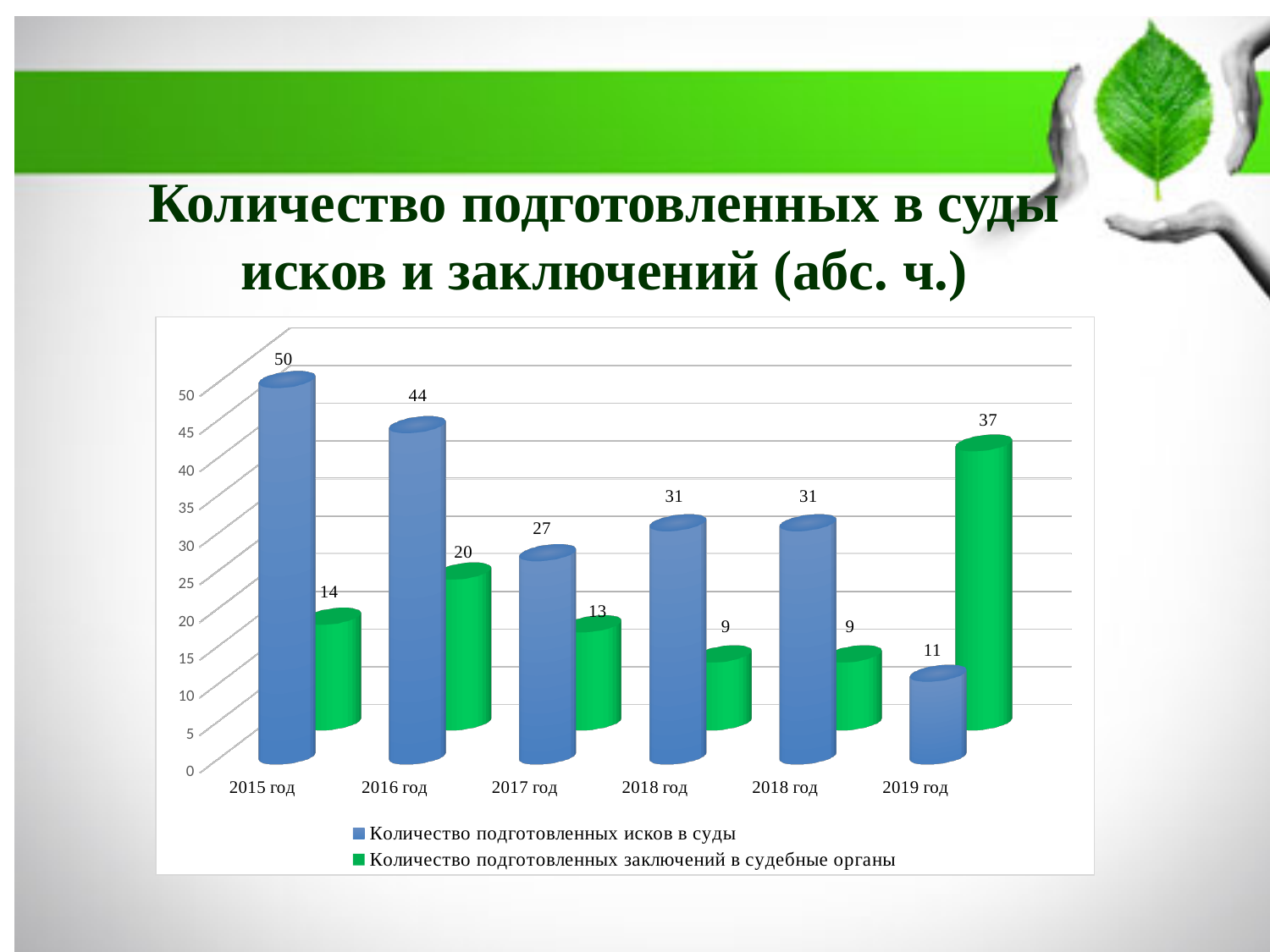
What is the value of 'Количество подготовленных исков в суды' for 2017 год? 27 In which year is 'Количество подготовленных исков в суды' lowest? 2019 год What is the difference between 'Количество подготовленных исков в суды' and 'Количество подготовленных заключений в судебные органы' in 2015 год? 36 What is the value of 'Количество подготовленных исков в суды' for 2015 год? 50 What is the value of 'Количество подготовленных заключений в судебные органы' for 2019 год? 37 What is the value of 'Количество подготовленных заключений в судебные органы' for 2016 год? 20 How many series does the legend list? 2 How many year categories are shown on the x axis? 6 In which year is 'Количество подготовленных исков в суды' highest? 2015 год In which year is 'Количество подготовленных заключений в судебные органы' highest? 2019 год In 2019 год, which series has the larger value: 'Количество подготовленных исков в суды' or 'Количество подготовленных заключений в судебные органы'? Количество подготовленных заключений в судебные органы What kind of chart is shown on the slide? bar chart